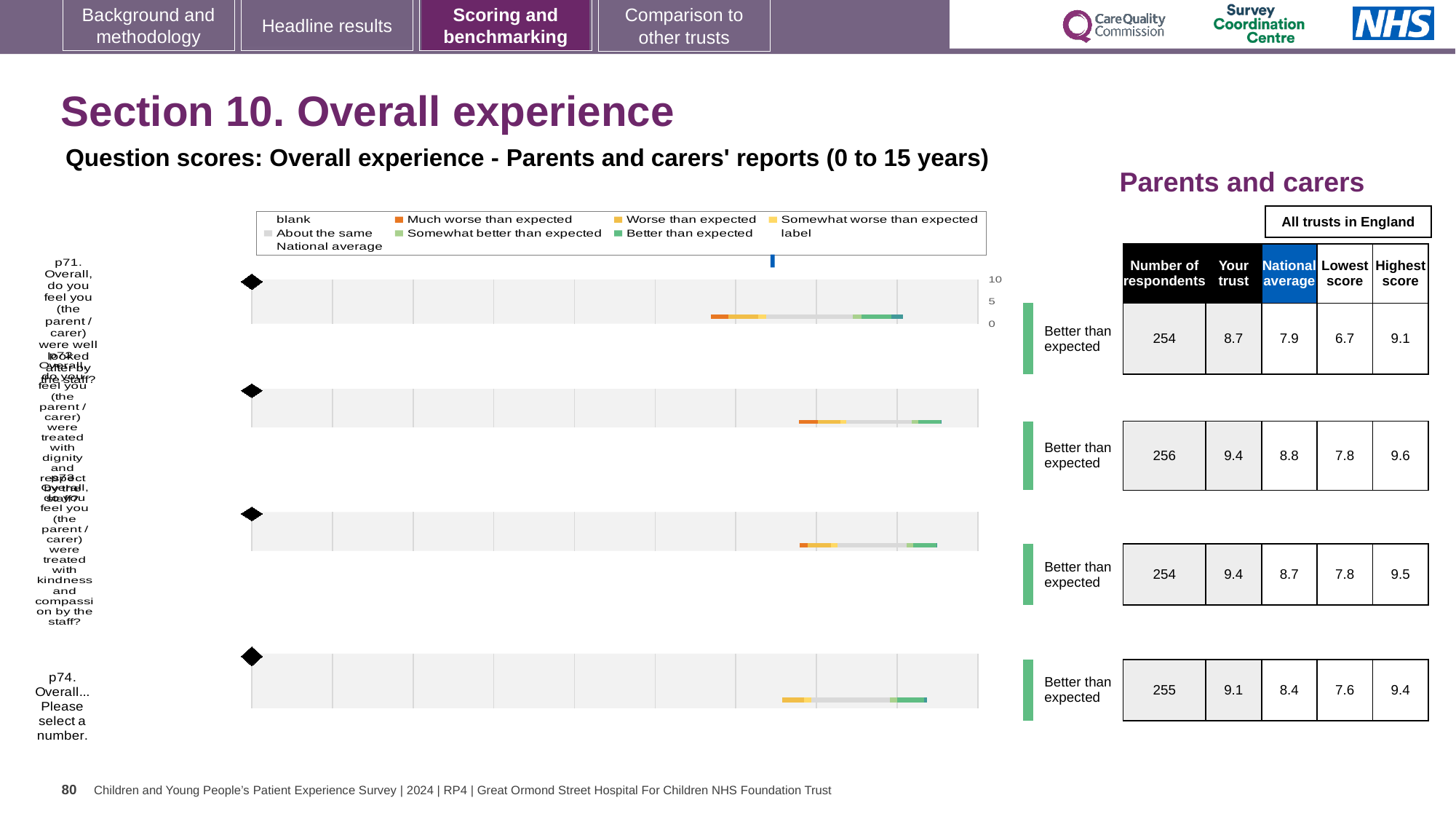
How many question bars are plotted in the chart? 4 What is the label of the bottom category in the chart? p74. Overall... Please select a number. What kind of chart is shown on the slide? bar chart What is the highest tick value shown on the chart's axis? 10 What colour does the legend use for 'Much worse than expected'? orange How many entries does the chart legend list? 9